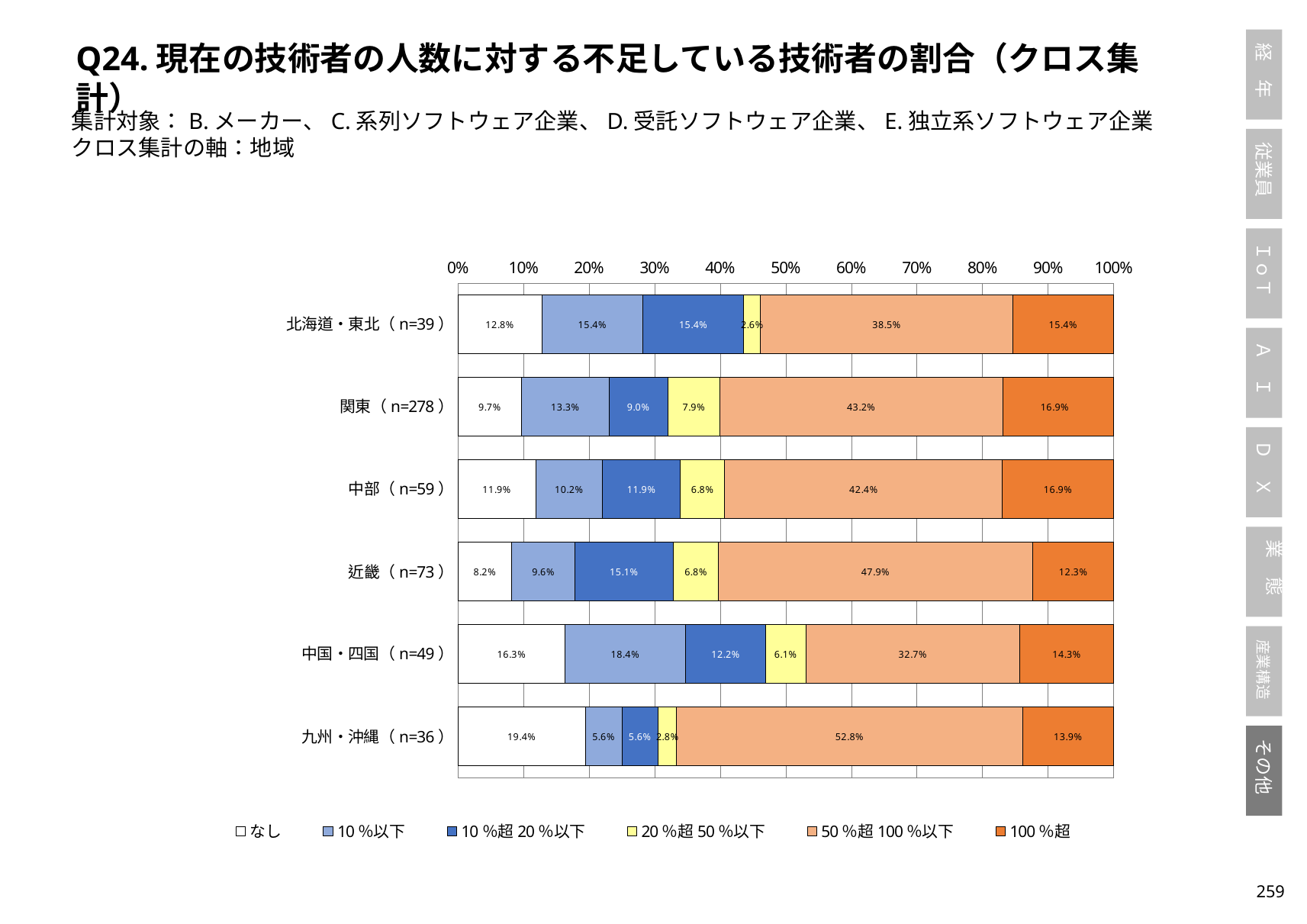
What type of chart is shown on the slide? Stacked bar chart What percentage of 関東 (n=278) respondents answered 50％超100％以下? 43.2% Which region has the lowest value for なし? 近畿 (n=73) What is the value for 100％超 in the 北海道・東北 (n=39) bar? 15.4% How many regions (categories) are shown in the chart? 6 Which legend entry is shown in yellow? 20％超50％以下 What is the difference between the 100％超 values for 関東 (n=278) and 近畿 (n=73)? 4.6 percentage points How many series does the legend list? 6 Which is larger: the 10％超20％以下 value for 近畿 (n=73) or for 九州・沖縄 (n=36)? 近畿 (n=73) What is the value for なし in the 九州・沖縄 (n=36) bar? 19.4% What percentage of 中国・四国 (n=49) respondents answered 10％以下? 18.4% Which region has the highest value for 50％超100％以下? 九州・沖縄 (n=36)